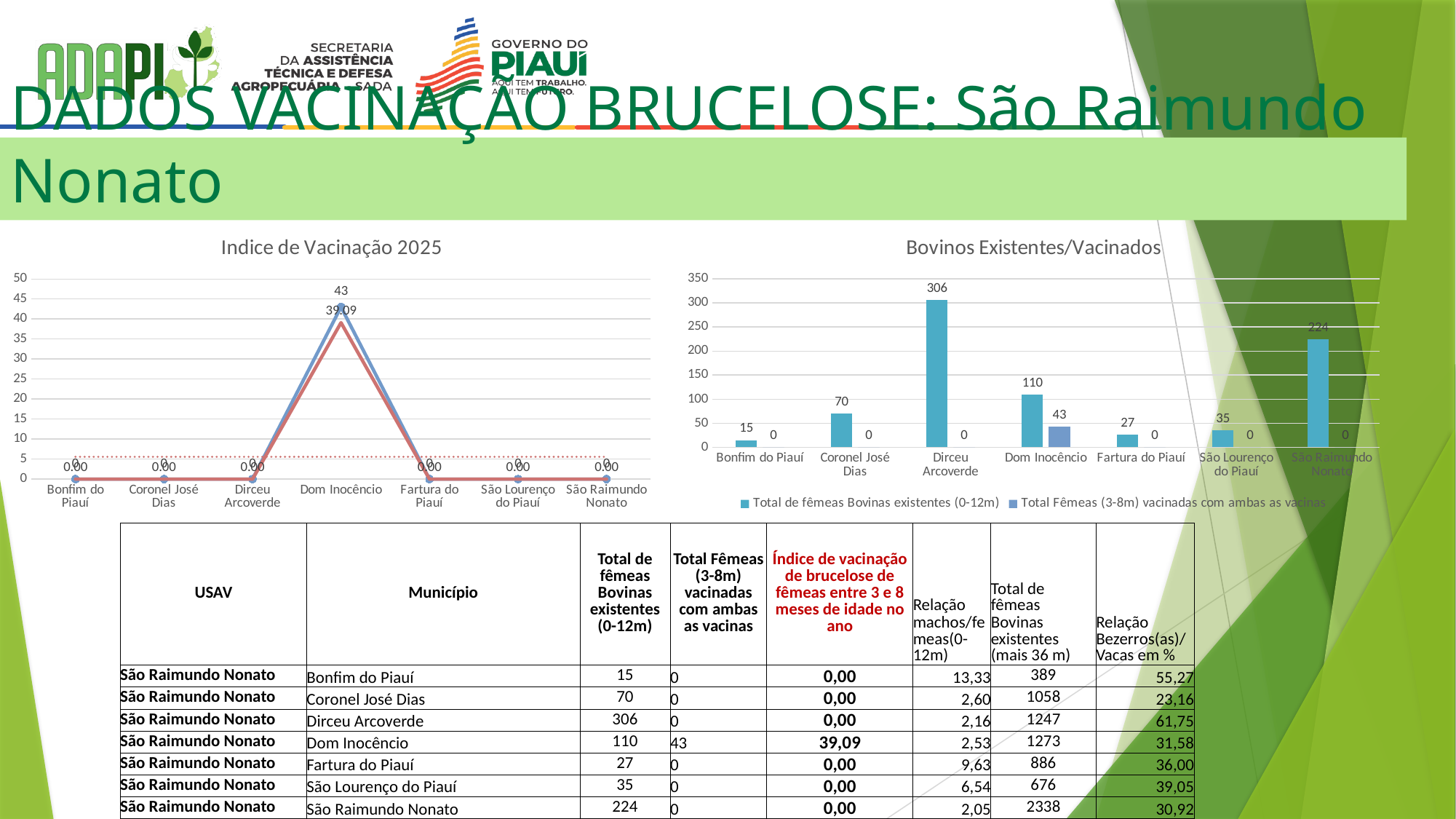
In the 'Bovinos Existentes/Vacinados' chart, which municipality has the highest value for 'Total de fêmeas Bovinas existentes (0-12m)'? Dirceu Arcoverde In the 'Bovinos Existentes/Vacinados' chart, what is the value of 'Total de fêmeas Bovinas existentes (0-12m)' for Dirceu Arcoverde? 306 In the 'Bovinos Existentes/Vacinados' chart, how many series does the legend list? 2 What kind of chart is 'Bovinos Existentes/Vacinados'? Bar chart In the 'Indice de Vacinação 2025' chart, what is the labelled value of the red line for Dom Inocêncio? 39.09 How many municipalities are shown on the x axis of the 'Bovinos Existentes/Vacinados' chart? 7 In the 'Bovinos Existentes/Vacinados' chart, what is the value of 'Total Fêmeas (3-8m) vacinadas com ambas as vacinas' for Dom Inocêncio? 43 In the 'Bovinos Existentes/Vacinados' chart, which is larger: the 'Total de fêmeas Bovinas existentes (0-12m)' value for Coronel José Dias or for Dom Inocêncio? Dom Inocêncio What kind of chart is 'Indice de Vacinação 2025'? Line chart In the 'Indice de Vacinação 2025' chart, which municipality has the highest value? Dom Inocêncio In the 'Bovinos Existentes/Vacinados' chart, what is the difference between the 'Total de fêmeas Bovinas existentes (0-12m)' values for Dirceu Arcoverde and São Raimundo Nonato? 82 In the 'Bovinos Existentes/Vacinados' chart, which municipality has the lowest value for 'Total de fêmeas Bovinas existentes (0-12m)'? Bonfim do Piauí